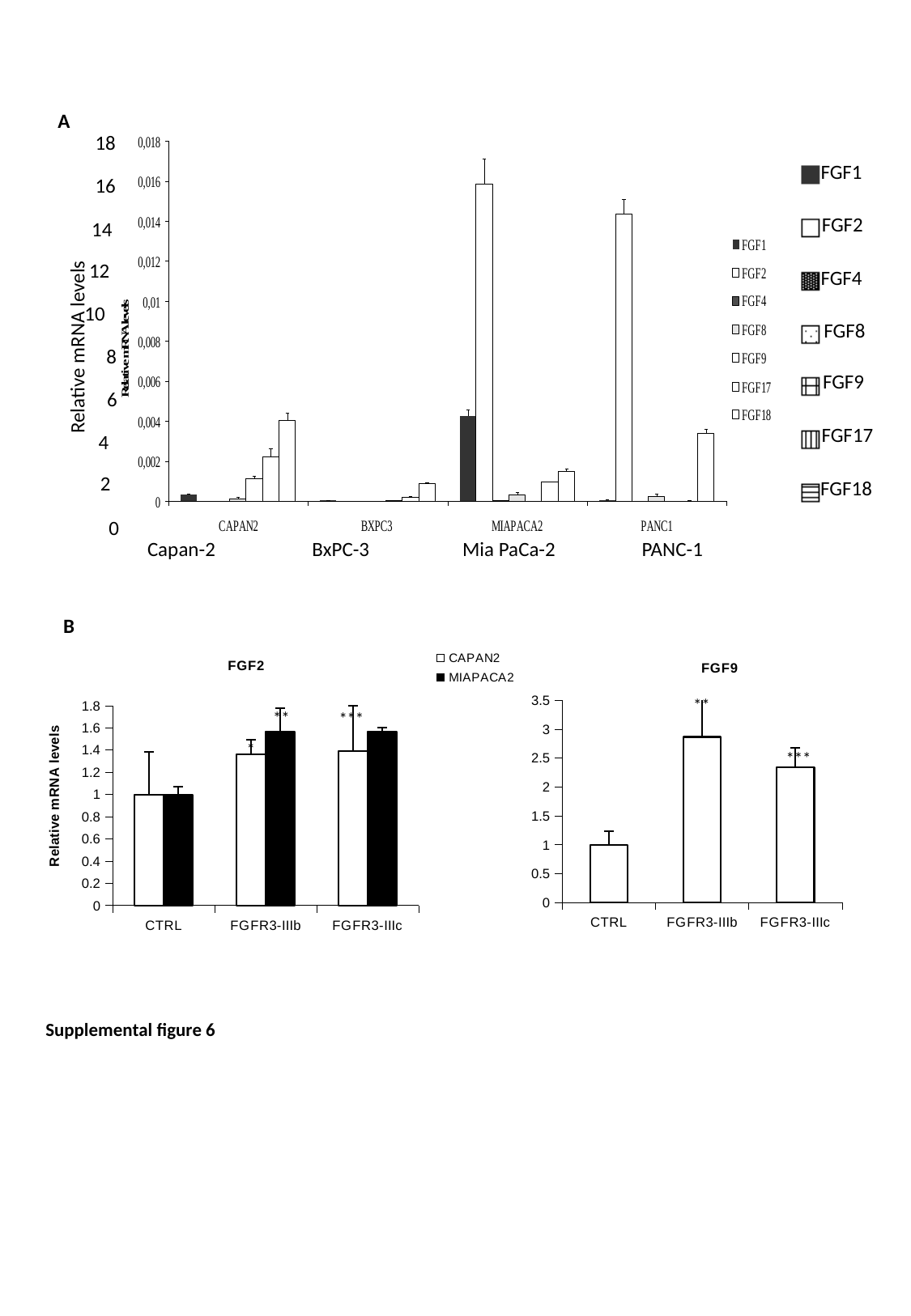
In the FGF2 chart in panel B, how many categories are shown on the x axis? 3 In the FGF9 chart in panel B, is the value for FGFR3-IIIb greater or less than 2.5? greater In the FGF2 chart in panel B, is the MIAPACA2 value for FGFR3-IIIb greater or less than 1.4? greater In the FGF9 chart in panel B, which category has the highest value? FGFR3-IIIb In the FGF2 chart in panel B, how many series does the legend list? 2 In the FGF9 chart in panel B, is the value for FGFR3-IIIc greater or less than 2? greater In the chart in panel A, how many series does the legend list? 7 In the chart in panel A, which cell line contains the tallest bar? Mia PaCa-2 What kind of chart is the FGF9 chart in panel B? bar chart In the FGF2 chart in panel B, at FGFR3-IIIb, which series has the larger value, CAPAN2 or MIAPACA2? MIAPACA2 In the FGF9 chart in panel B, which category has the lowest value? CTRL